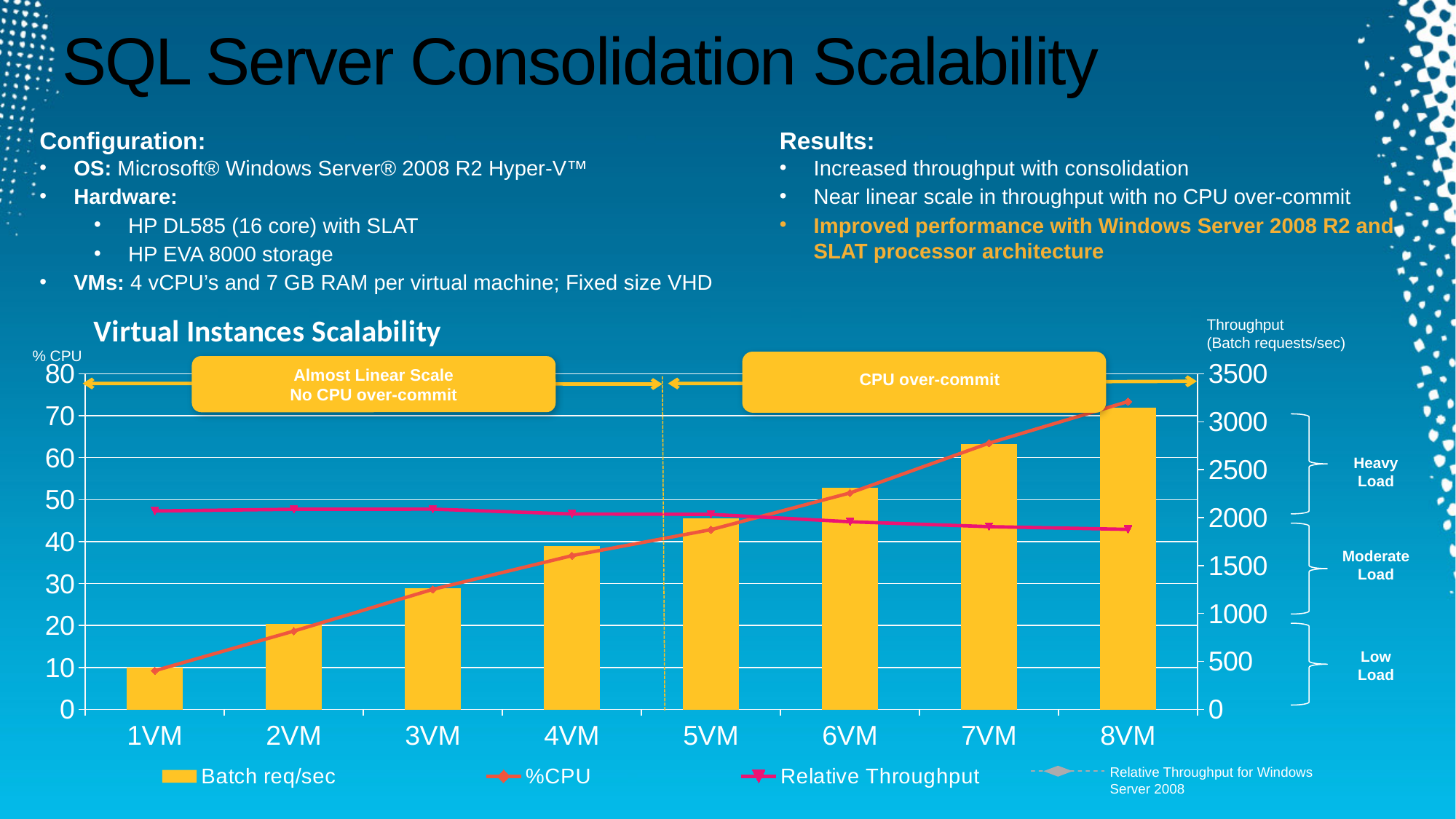
How many series does the chart legend list? 4 Which has the larger Batch req/sec bar, 5VM or 7VM? 7VM Is the Batch req/sec value for 8VM greater or less than 3000 on the Throughput axis? greater Do the Batch req/sec bars rise or fall from 1VM to 8VM? Rise What is the title of the chart on the slide? Virtual Instances Scalability Does the %CPU line rise or fall from 1VM to 8VM? Rise Is the Batch req/sec value for 4VM greater or less than 2000 on the Throughput axis? less Which VM category has the highest Batch req/sec bar? 8VM Which VM category has the lowest Batch req/sec bar? 1VM What kind of chart is shown on the slide? Combined bar and line chart Is the %CPU value for 8VM greater or less than 70? greater How many VM categories are shown on the x axis of the chart? 8